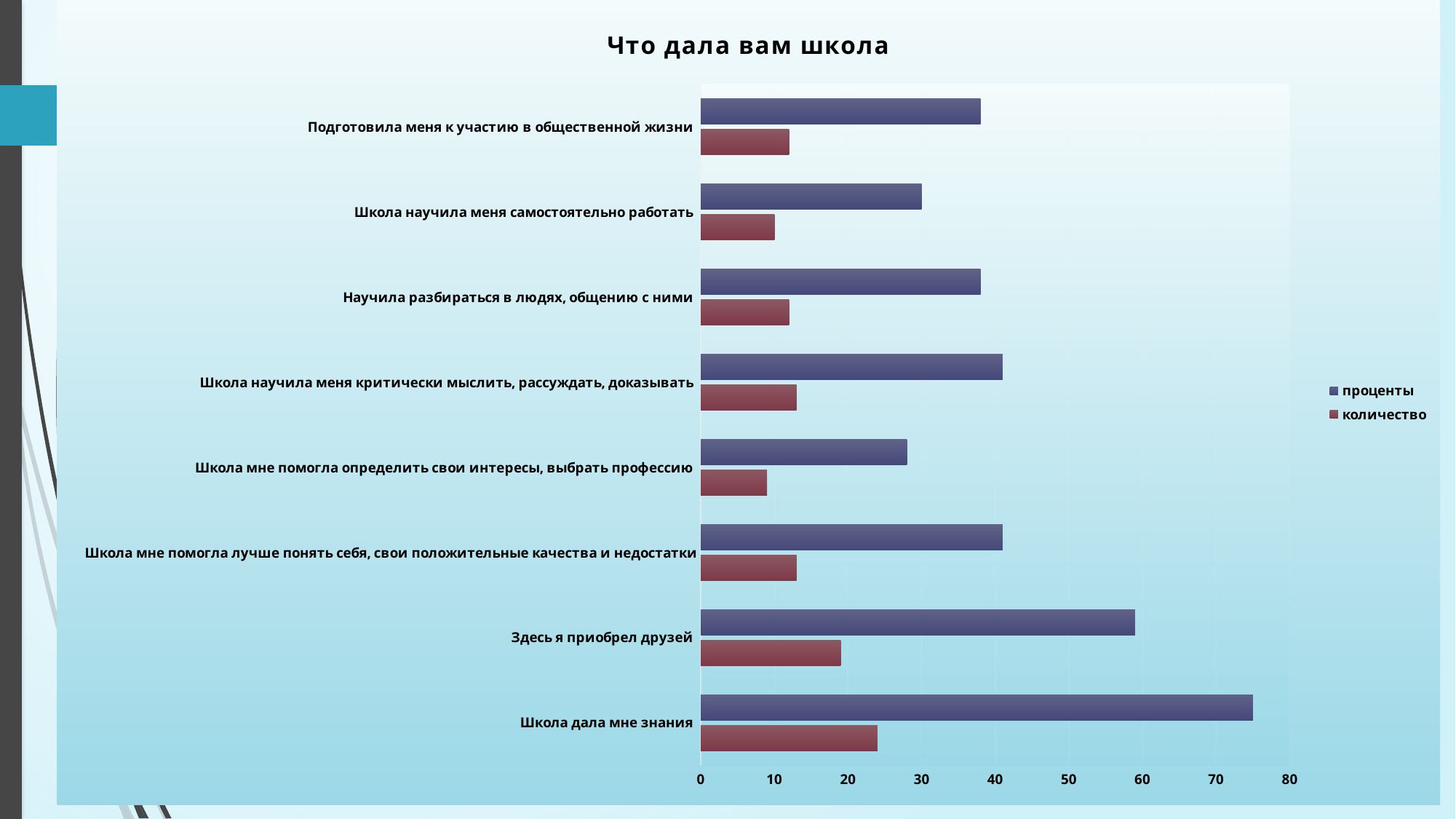
How many series does the legend list? 2 Which is larger: the проценты value for 'Здесь я приобрел друзей' or for 'Школа научила меня самостоятельно работать'? Здесь я приобрел друзей Which category has the highest value for количество? Школа дала мне знания How many categories are shown on the chart? 8 Is the проценты value for 'Здесь я приобрел друзей' greater or less than 50? greater Which category has the highest value for проценты? Школа дала мне знания Which category has the lowest value for проценты? Школа мне помогла определить свои интересы, выбрать профессию What kind of chart is shown on the slide? bar chart Which series is shown in red bars? количество What is the title of the chart? Что дала вам школа Is the проценты value for 'Школа дала мне знания' greater or less than 70? greater